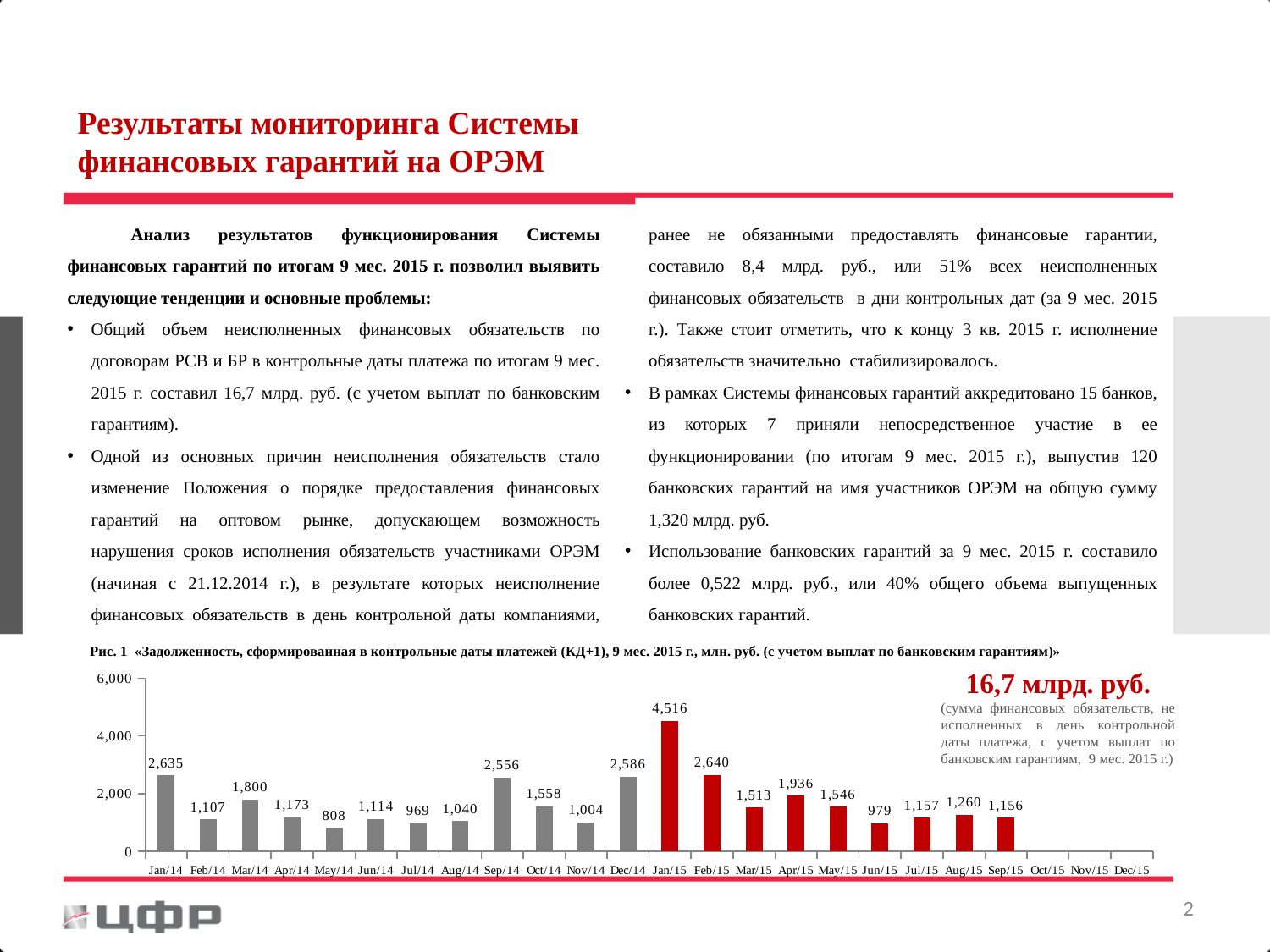
How many bars with data labels are shown in the chart? 21 What is the difference between the values for Jan/14 and Feb/14? 1,528 Which month has the highest value in the chart? Jan/15 What colour are the bars for the 2015 months in the chart? red What is the value for Jan/15 in the chart? 4,516 What type of chart is shown on the slide? bar chart Is the value for Jan/15 greater or less than 4,000? greater What is the value for Sep/15 in the chart? 1,156 What is the difference between the values for Jan/15 and Feb/15? 1,876 Which month has the lowest value in the chart? May/14 What is the value for May/14 in the chart? 808 Which is larger, the value for Sep/14 or the value for Dec/14? Dec/14